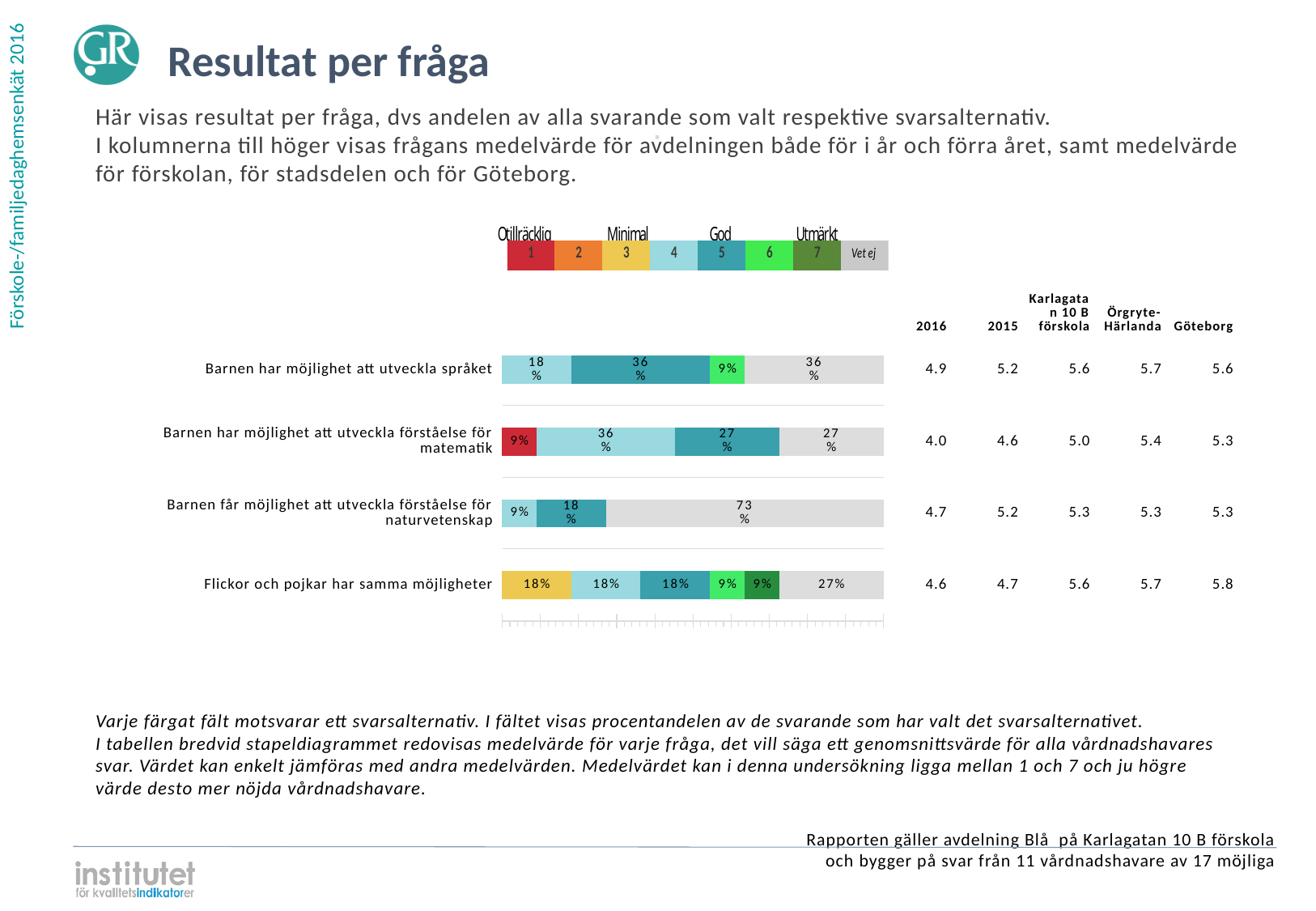
What colour represents the 'Vet ej' answer alternative in the chart? Grey Which is larger for 'Barnen har möjlighet att utveckla förståelse för matematik': the share for rating 4 or the share for rating 5? Rating 4 How many questions (categories) are plotted in the bar chart? 4 Which question has the largest 'Vet ej' share? Barnen får möjlighet att utveckla förståelse för naturvetenskap What percentage chose rating 7 for 'Flickor och pojkar har samma möjligheter'? 9% Which question has the lowest 2016 mean value in the table? Barnen har möjlighet att utveckla förståelse för matematik How many answer alternatives does the colour legend above the chart list? 8 What percentage of respondents answered 'Vet ej' for 'Barnen får möjlighet att utveckla förståelse för naturvetenskap'? 73% What kind of chart is shown on the slide? Stacked bar chart What percentage chose rating 1 (Otillräcklig) for 'Barnen har möjlighet att utveckla förståelse för matematik'? 9% What is the difference between the rating-5 share for 'Barnen har möjlighet att utveckla språket' and the rating-5 share for 'Barnen får möjlighet att utveckla förståelse för naturvetenskap'? 18 percentage points What is the 2016 mean value for 'Barnen har möjlighet att utveckla förståelse för matematik'? 4.0